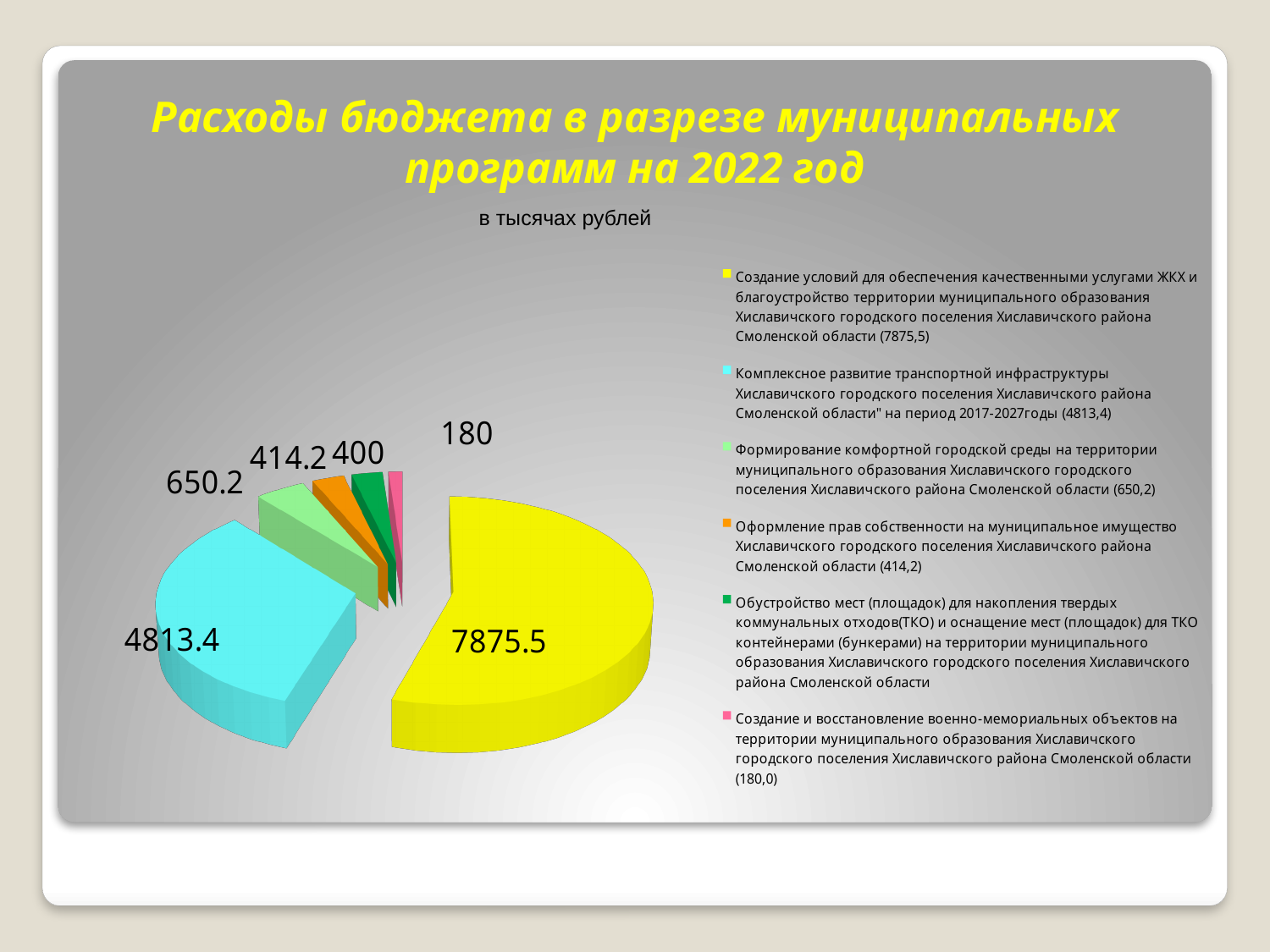
What value is shown for the slice 'Обустройство мест (площадок) для накопления твердых коммунальных отходов (ТКО)'? 400 How many slices does the pie chart have? 6 What value is shown for the slice 'Оформление прав собственности на муниципальное имущество Хиславичского городского поселения'? 414.2 What value is shown for the slice 'Комплексное развитие транспортной инфраструктуры Хиславичского городского поселения'? 4813.4 Which slice is larger: 'Оформление прав собственности на муниципальное имущество' or 'Создание и восстановление военно-мемориальных объектов'? Оформление прав собственности на муниципальное имущество In what units are the values in the chart expressed, according to the subtitle? в тысячах рублей What kind of chart is shown on the slide? pie chart What value is shown for the slice 'Формирование комфортной городской среды на территории муниципального образования Хиславичского городского поселения'? 650.2 How many entries does the legend of the pie chart list? 6 What is the value of the smallest slice in the pie chart? 180 What is the difference between the two largest slices, 7875.5 and 4813.4? 3062.1 What is the value of the largest slice in the pie chart? 7875.5